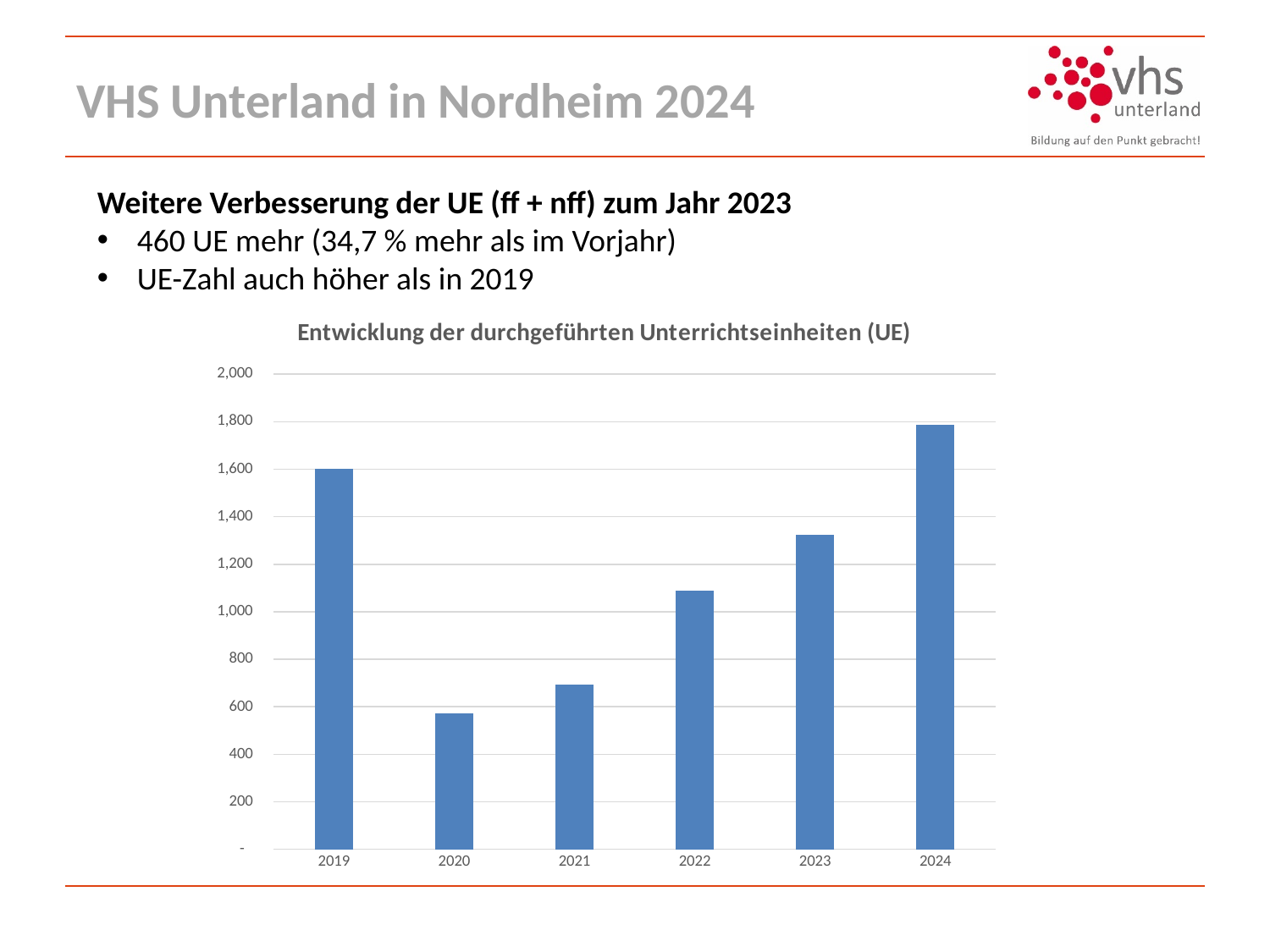
Is the value for 2024 greater or less than 1,600? greater Which is larger, the value for 2021 or the value for 2022? 2022 Is the value for 2022 greater or less than 1,000? greater What type of chart is shown on the slide? bar chart Which year has the highest value in the chart? 2024 How many years are shown on the x axis of the chart? 6 What is the title of the chart? Entwicklung der durchgeführten Unterrichtseinheiten (UE) Do the values rise or fall from 2020 to 2024? rise Is the value for 2020 greater or less than 600? less Which year has the lowest value in the chart? 2020 Which is larger, the value for 2019 or the value for 2023? 2019